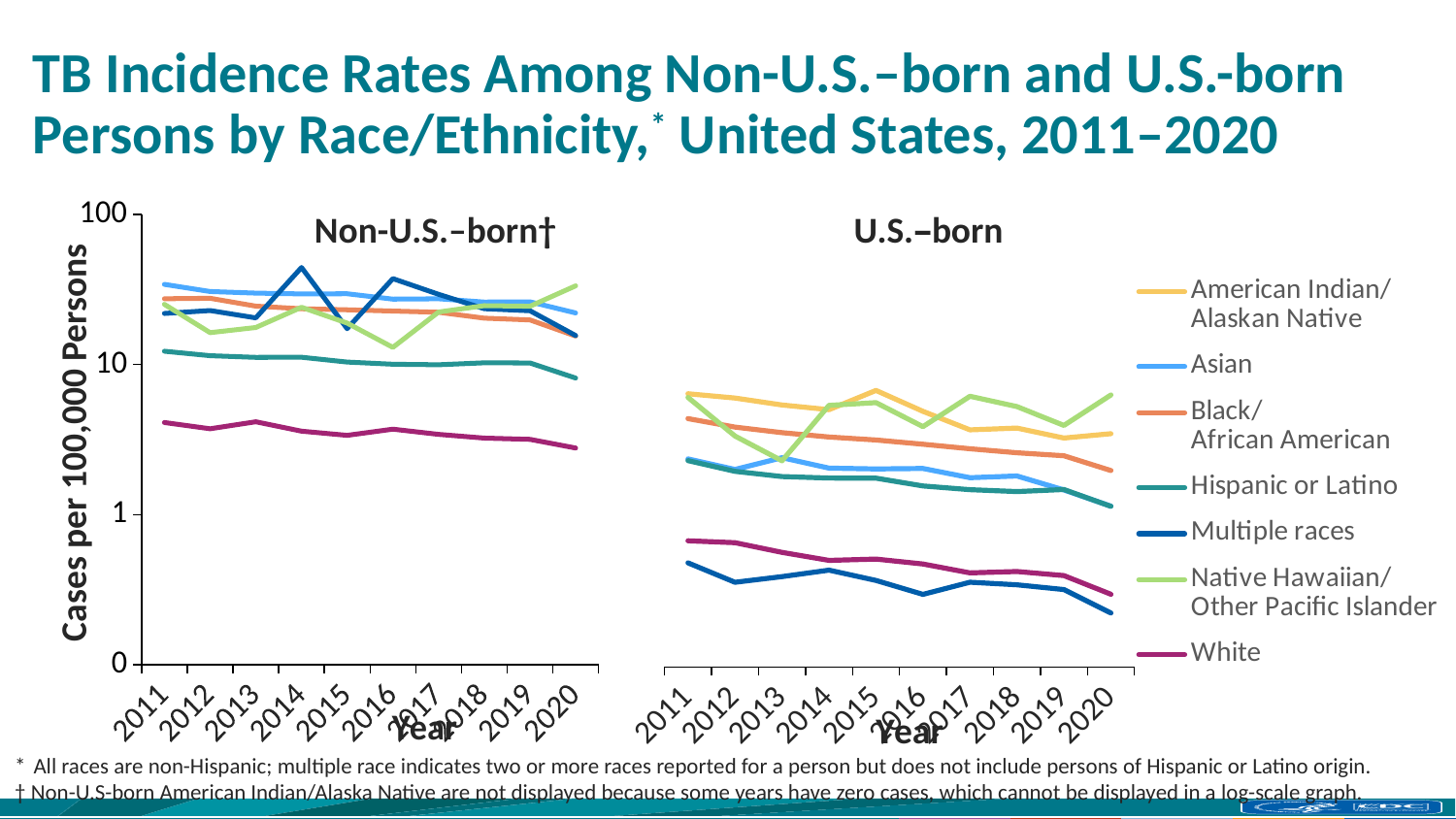
In the Non-U.S.-born chart, is the value for White in 2011 greater or less than 10? less In the U.S.-born chart, which is larger in 2020: Native Hawaiian/Other Pacific Islander or White? Native Hawaiian/Other Pacific Islander What is the label on the y axis? Cases per 100,000 Persons In the Non-U.S.-born chart, which series has the lowest values across all years? White What kind of chart is used on this slide to show TB incidence rates? Line chart In the U.S.-born chart, which series has the lowest value in 2020? Multiple races In the U.S.-born chart, is the value for Multiple races in 2020 greater or less than 1? less In the U.S.-born chart, is the value for American Indian/Alaskan Native in 2011 greater or less than 10? less How many series does the legend list? 7 How many years are shown on the x axis of the U.S.-born chart? 10 In the U.S.-born chart, does the Black/African American line rise or fall from 2011 to 2020? Fall